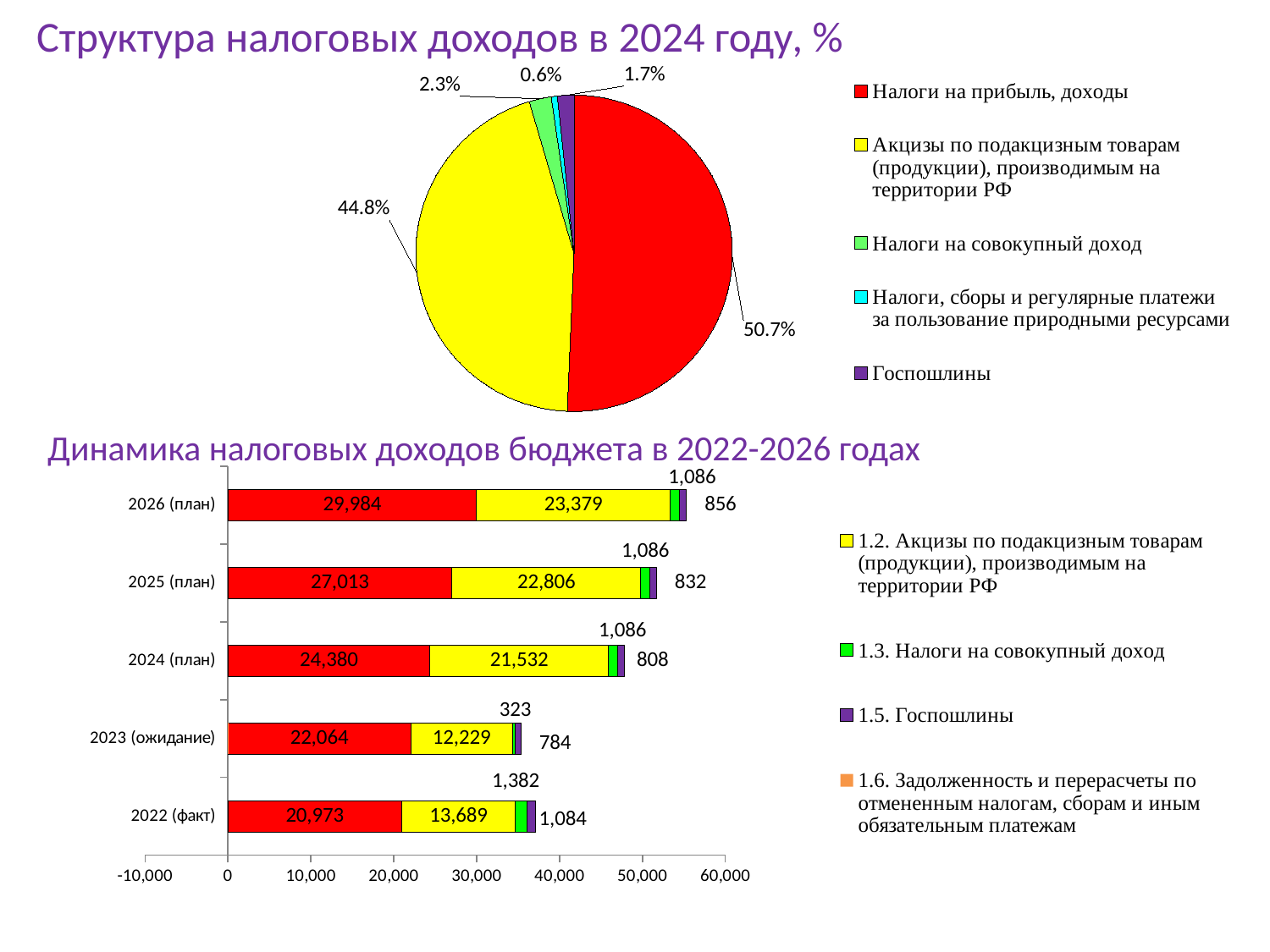
In the chart 'Динамика налоговых доходов бюджета в 2022-2026 годах', what is the value of the yellow segment (Акцизы) for 2024 (план)? 21,532 In the pie chart 'Структура налоговых доходов в 2024 году, %', which category has the largest slice? Налоги на прибыль, доходы In the chart 'Динамика налоговых доходов бюджета в 2022-2026 годах', what is the value of the red segment for 2022 (факт)? 20,973 How many slices does the pie chart 'Структура налоговых доходов в 2024 году, %' have? 5 In the chart 'Динамика налоговых доходов бюджета в 2022-2026 годах', what is the difference between the red segments for 2026 (план) and 2025 (план)? 2,971 In the chart 'Динамика налоговых доходов бюджета в 2022-2026 годах', does the red segment rise or fall from 2022 (факт) to 2026 (план)? Rises In the pie chart 'Структура налоговых доходов в 2024 году, %', what share does 'Акцизы по подакцизным товарам (продукции), производимым на территории РФ' have? 44.8% In the chart 'Динамика налоговых доходов бюджета в 2022-2026 годах', which year has the largest red segment? 2026 (план) In the pie chart 'Структура налоговых доходов в 2024 году, %', what share does 'Налоги на прибыль, доходы' have? 50.7% In the pie chart 'Структура налоговых доходов в 2024 году, %', which category has the smallest slice? Налоги, сборы и регулярные платежи за пользование природными ресурсами What type of chart is 'Динамика налоговых доходов бюджета в 2022-2026 годах'? Stacked bar chart In the chart 'Динамика налоговых доходов бюджета в 2022-2026 годах', is the yellow segment (Акцизы) larger for 2022 (факт) or 2023 (ожидание)? 2022 (факт)